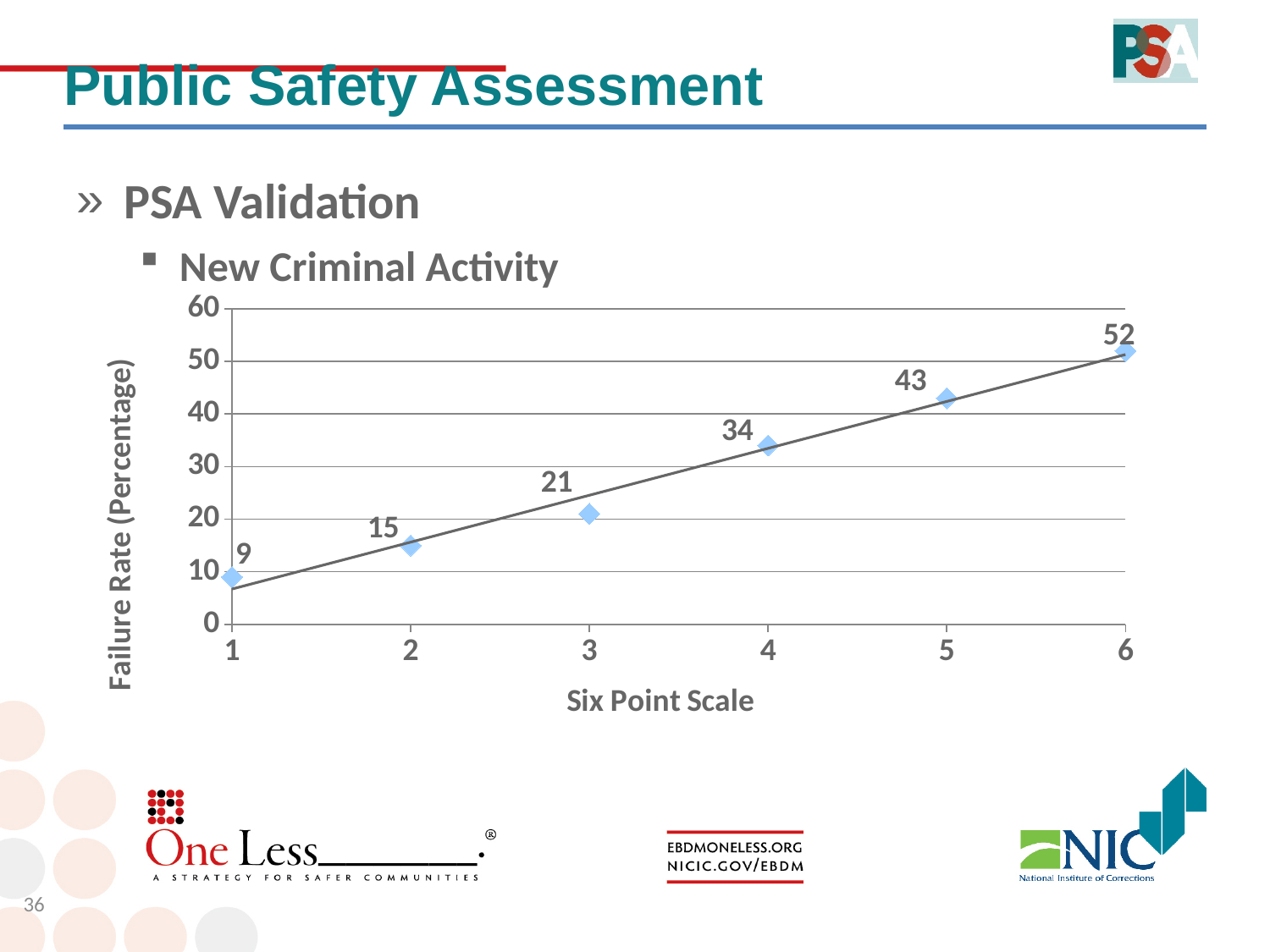
How many data points are plotted on the chart? 6 What is the label of the x axis? Six Point Scale Which has a higher failure rate, point 2 or point 3? 3 What is the label of the y axis? Failure Rate (Percentage) What is the difference in failure rate between point 6 and point 1? 43 Does the failure rate rise or fall as the Six Point Scale increases? rise What is the failure rate at point 6 on the Six Point Scale? 52 Which point on the Six Point Scale has the lowest failure rate? 1 Which point on the Six Point Scale has the highest failure rate? 6 What is the failure rate at point 1 on the Six Point Scale? 9 What is the failure rate at point 4 on the Six Point Scale? 34 What is the difference in failure rate between point 5 and point 3? 22